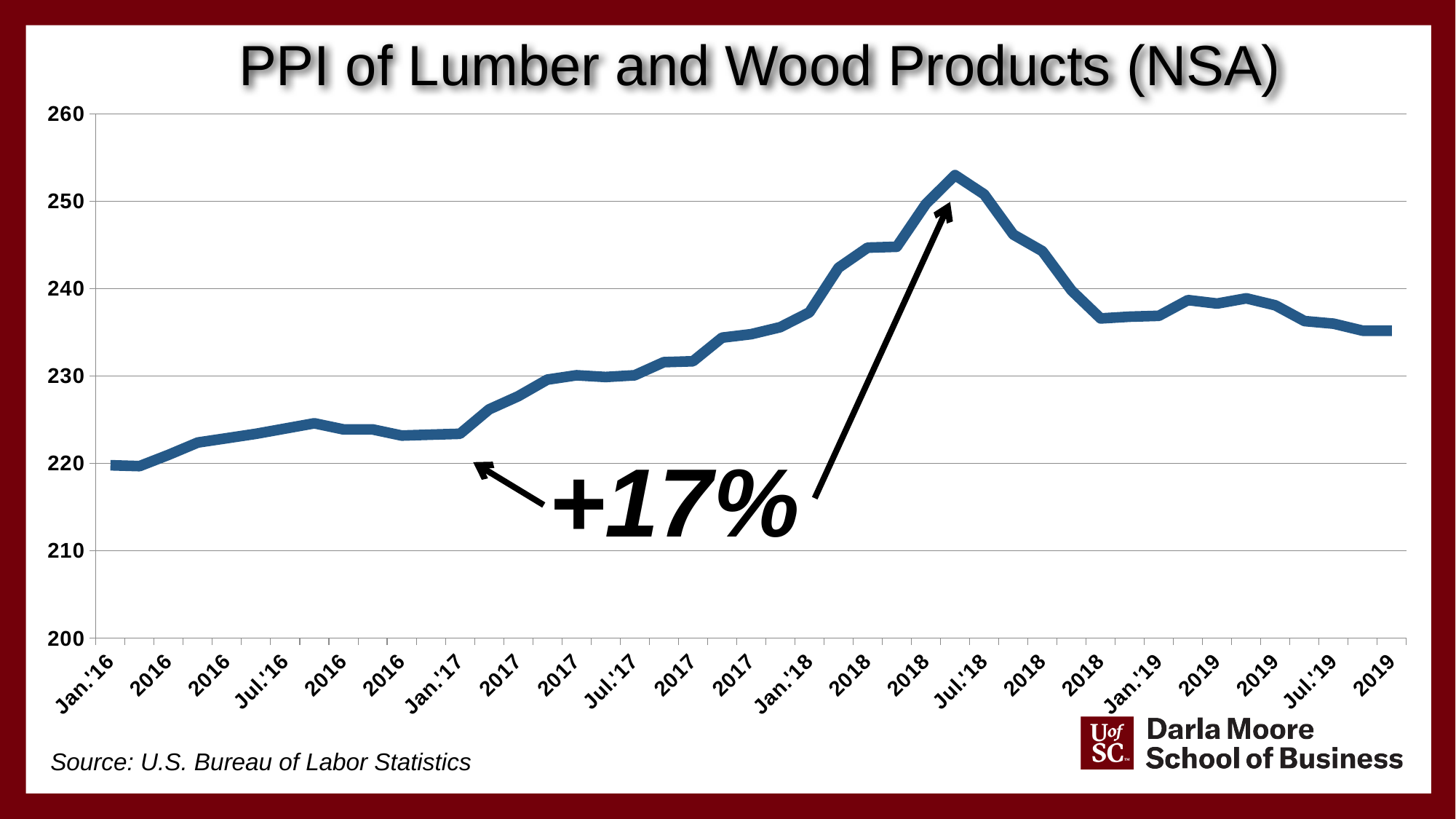
Is the value for Jul '16 greater or less than 230? less Does the line rise or fall between Jul '18 and Jan '19? fall Is the value for Jul '19 greater or less than 230? greater Which is larger, the value for Jan '17 or the value for Jan '18? Jan '18 Is the value for Jul '18 greater or less than 240? greater What is the title of the chart? PPI of Lumber and Wood Products (NSA) What kind of chart is shown on the slide? line chart Which is larger, the value for Jul '18 or the value for Jul '19? Jul '18 In which year does the line reach its highest value? 2018 What percentage change is annotated on the chart between early 2017 and mid-2018? +17%